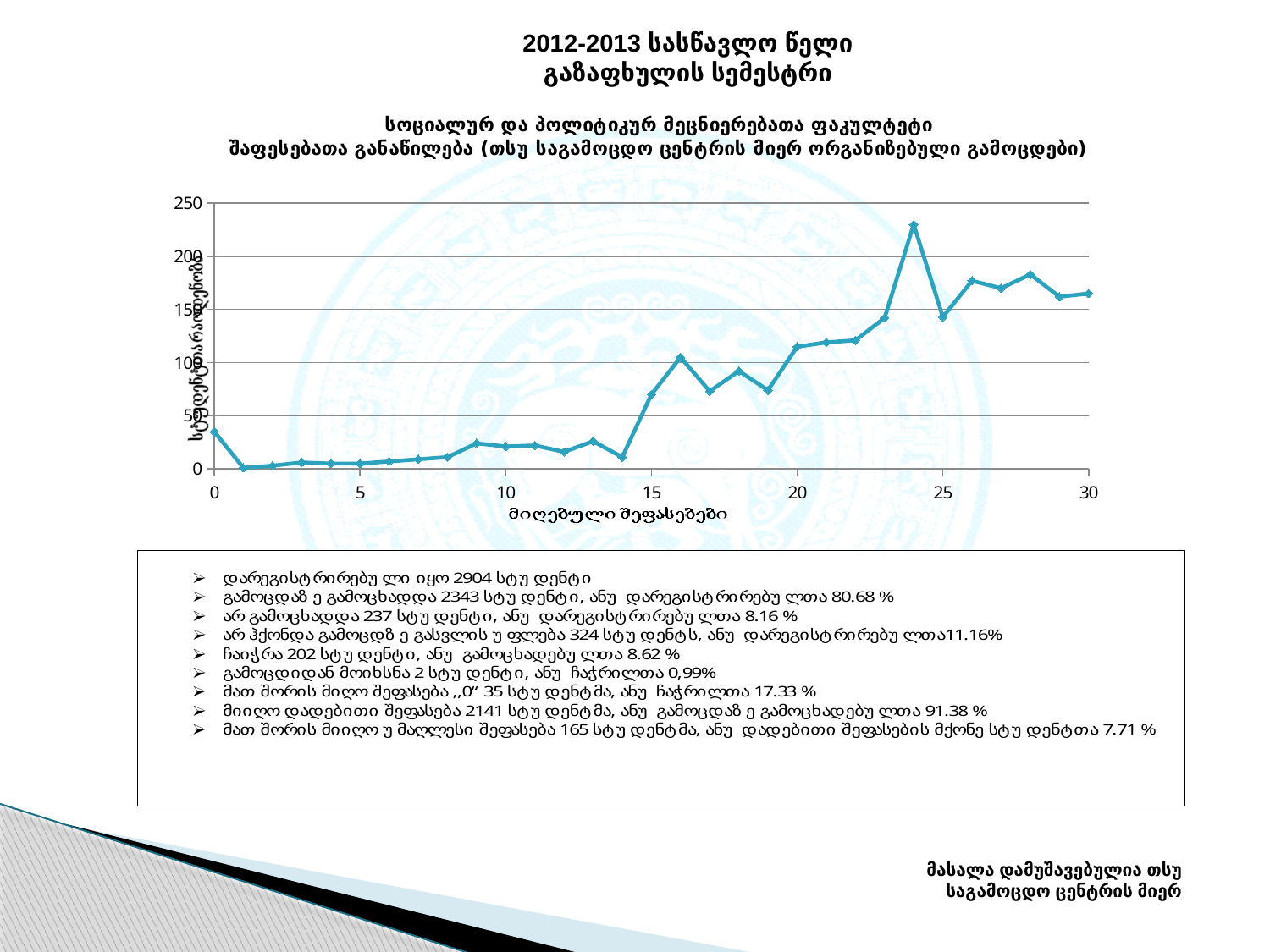
What is the highest tick value shown on the x-axis? 30 Which has the larger value, score 24 or score 28? 24 Is the value at score 0 greater or less than 50? less Is the value at score 14 greater or less than 50? less Does the line rise or fall between score 24 and score 25? fall At which x-axis score does the line reach its highest value? 24 What is the highest tick value shown on the y-axis? 250 Which has the larger value, score 5 or score 15? 15 Is the value at score 24 greater or less than 200? greater What kind of chart is shown on the slide? line chart